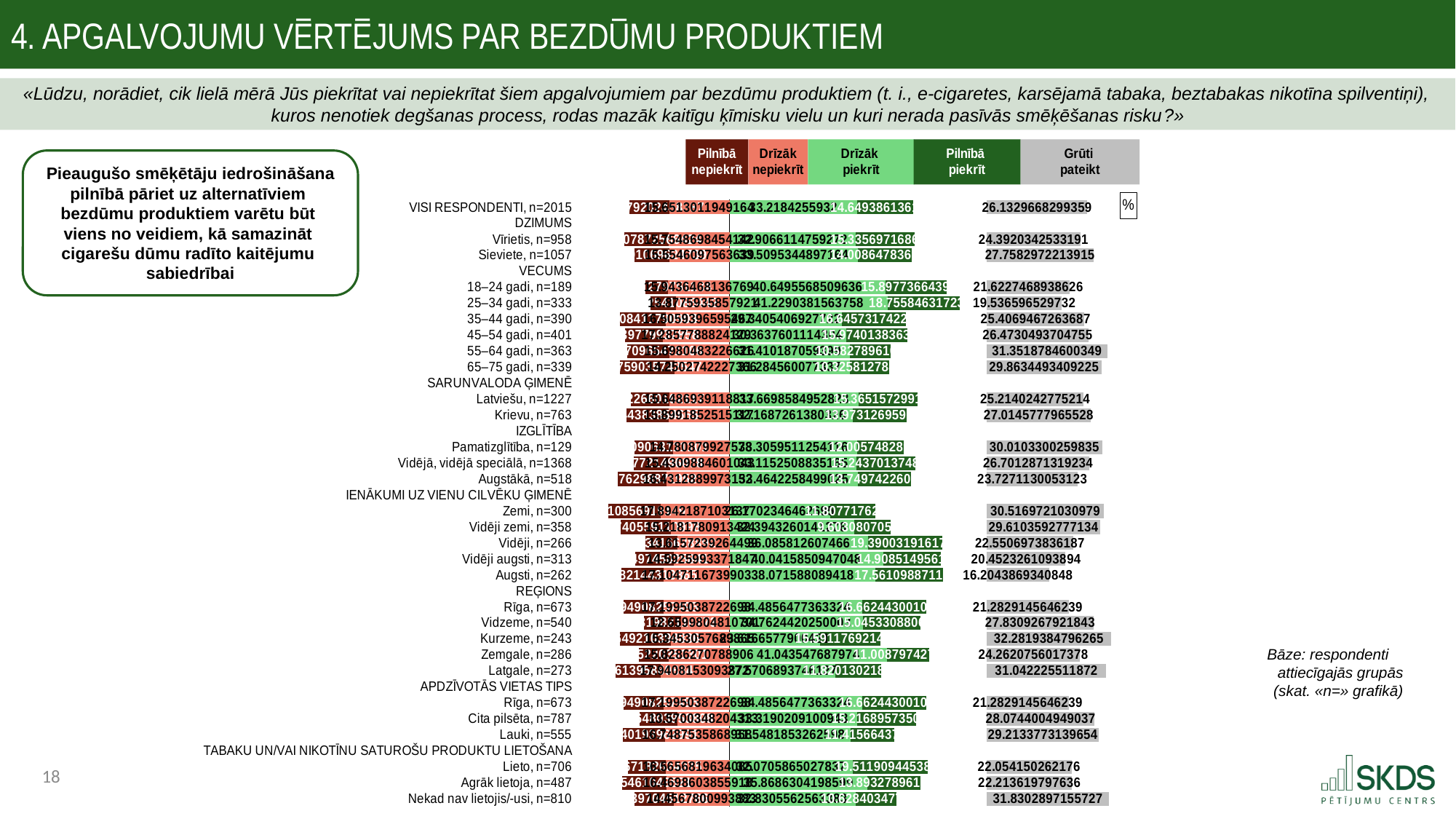
Which legend entry is shown in grey? Grūti pateikt What is the 'Grūti pateikt' value for VISI RESPONDENTI, n=2015? 26.1329668299359 How many age groups (VECUMS) are shown in the chart? 6 How many series does the legend list? 5 What is the 'Grūti pateikt' value for Sieviete, n=1057? 27.7582972213915 Which has the larger 'Grūti pateikt' value: Vīrietis, n=958 or Sieviete, n=1057? Sieviete, n=1057 What is the 'Grūti pateikt' value for Kurzeme, n=243? 32.2819384796265 Among the IENĀKUMI UZ VIENU CILVĒKU ĢIMENĒ groups, which has the lowest 'Grūti pateikt' value? Augsti, n=262 What is the difference between the 'Grūti pateikt' values for Sieviete, n=1057 and Vīrietis, n=958? 3.3662629680724 What is the 'Grūti pateikt' value for Nekad nav lietojis/-usi, n=810? 31.8302897155727 What kind of chart is shown on the slide? bar chart Among the REĢIONS groups, which has the highest 'Grūti pateikt' value? Kurzeme, n=243